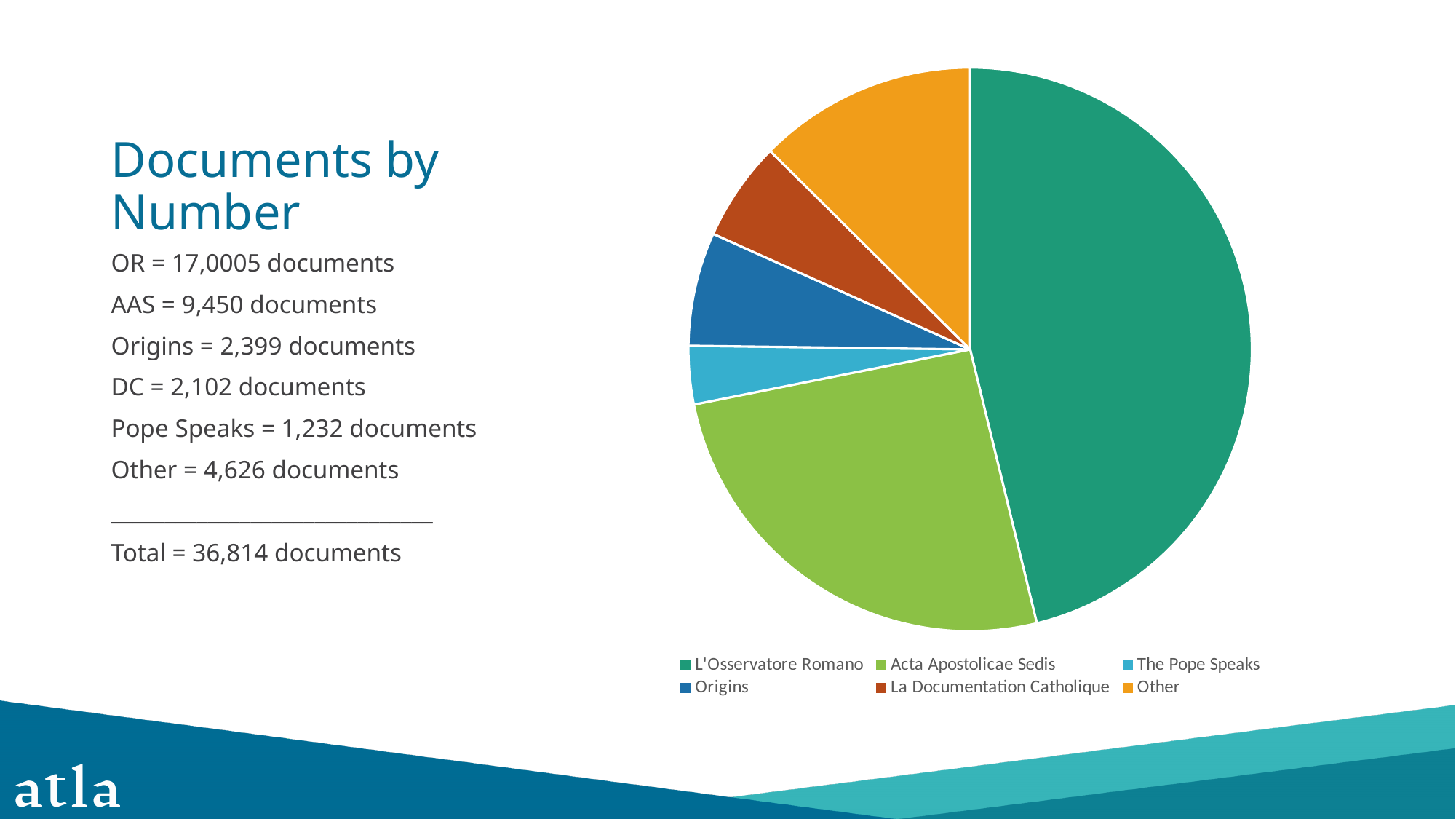
How many slices does the pie chart have? 6 What is the total number of documents stated on the slide? 36,814 documents What kind of chart is shown on the slide? pie chart According to the slide text, what is the difference between the number of Origins documents and DC documents? 297 documents Which category has the smallest slice of the pie chart? The Pope Speaks What is the title of the slide containing the pie chart? Documents by Number How many entries does the legend of the pie chart list? 6 Which category has the largest slice of the pie chart? L'Osservatore Romano Which slice is larger, Origins or The Pope Speaks? Origins Which slice is larger, Acta Apostolicae Sedis or Other? Acta Apostolicae Sedis According to the slide text, how many documents are listed for Origins? 2,399 documents According to the slide text, how many documents are listed for Pope Speaks? 1,232 documents